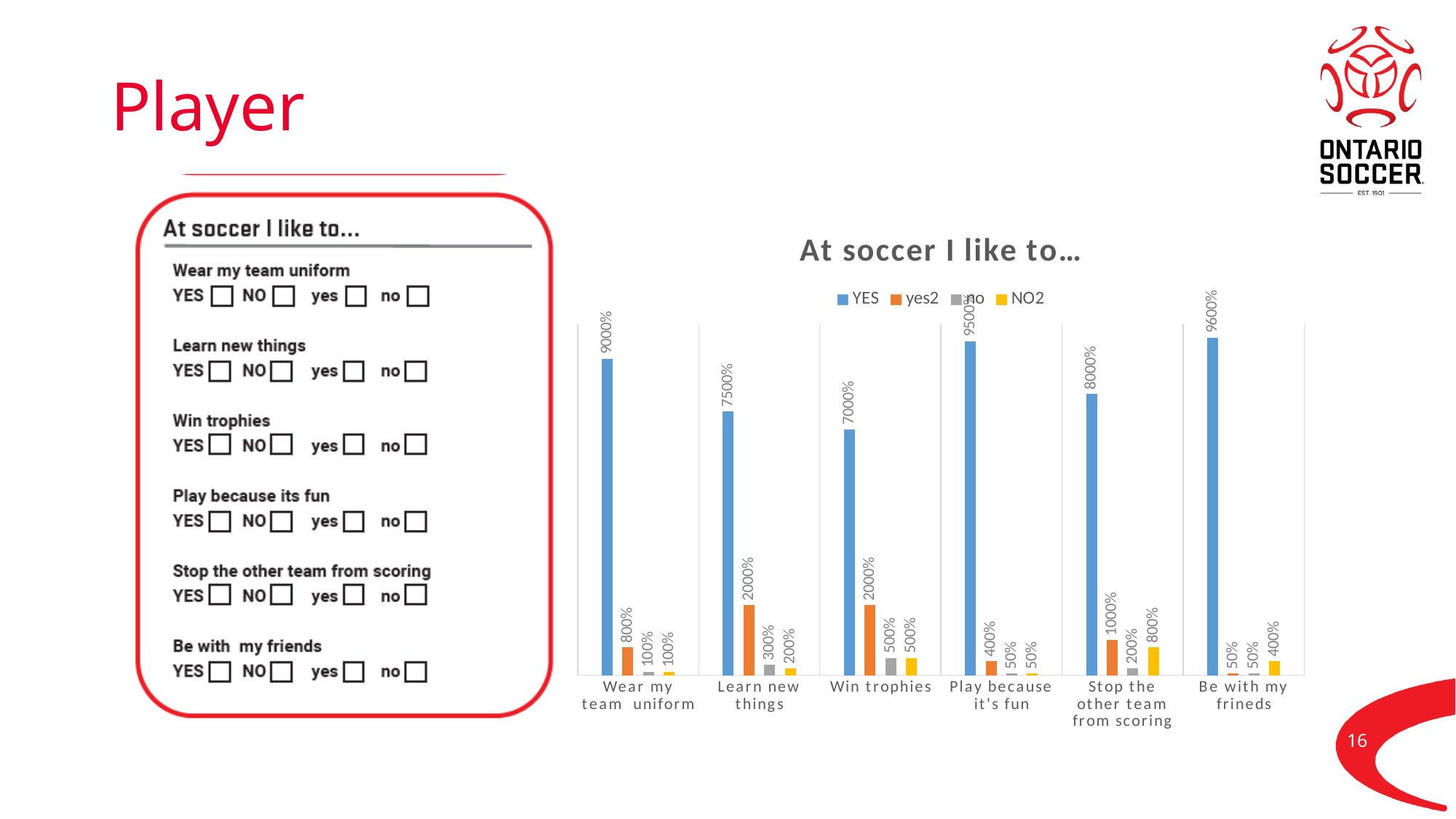
What is the YES value for "Play because it's fun"? 9500% What type of chart is shown on the slide? Bar chart What is the difference between the YES values for "Play because it's fun" and "Learn new things"? 2000% What is the yes2 value for "Learn new things"? 2000% Which is larger: the yes2 value for "Wear my team uniform" or the yes2 value for "Stop the other team from scoring"? Stop the other team from scoring How many series does the chart legend list? 4 What is the title of the chart? At soccer I like to… Which category has the highest YES value? Be with my frineds Which category has the lowest YES value? Win trophies How many categories are shown on the x axis of the chart? 6 What is the YES value for "Wear my team uniform"? 9000% What is the NO2 value for "Stop the other team from scoring"? 800%